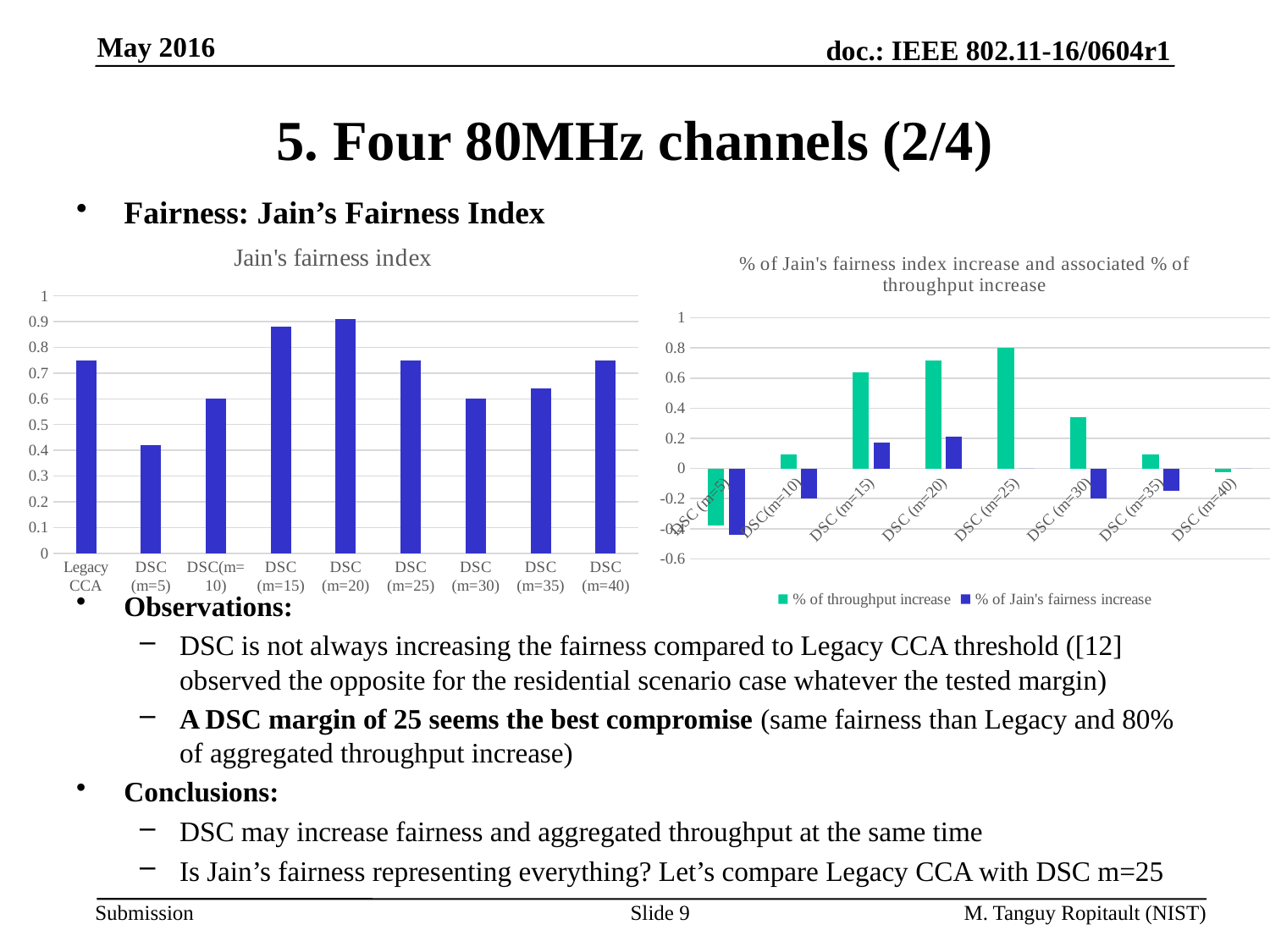
In the right-hand chart, which series is drawn in green? % of throughput increase In the 'Jain's fairness index' chart, which is larger, the value for DSC (m=15) or the value for DSC (m=35)? DSC (m=15) In the 'Jain's fairness index' chart, how many categories are shown on the x axis? 9 In the 'Jain's fairness index' chart, which category has the highest fairness index? DSC (m=20) In the right-hand chart, which category has the lowest % of throughput increase? DSC (m=5) In the right-hand chart, which category has the highest % of throughput increase? DSC (m=25) How many series does the legend of the right-hand chart ('% of Jain's fairness index increase and associated % of throughput increase') list? 2 In the 'Jain's fairness index' chart, which category has the lowest fairness index? DSC (m=5) What kind of chart is the 'Jain's fairness index' chart on the left? bar chart In the 'Jain's fairness index' chart, is the value for Legacy CCA greater or less than 0.7? greater In the right-hand chart, for DSC (m=20), which is larger: the % of throughput increase or the % of Jain's fairness increase? % of throughput increase In the right-hand chart, is the % of throughput increase for DSC (m=15) greater or less than 0.5? greater